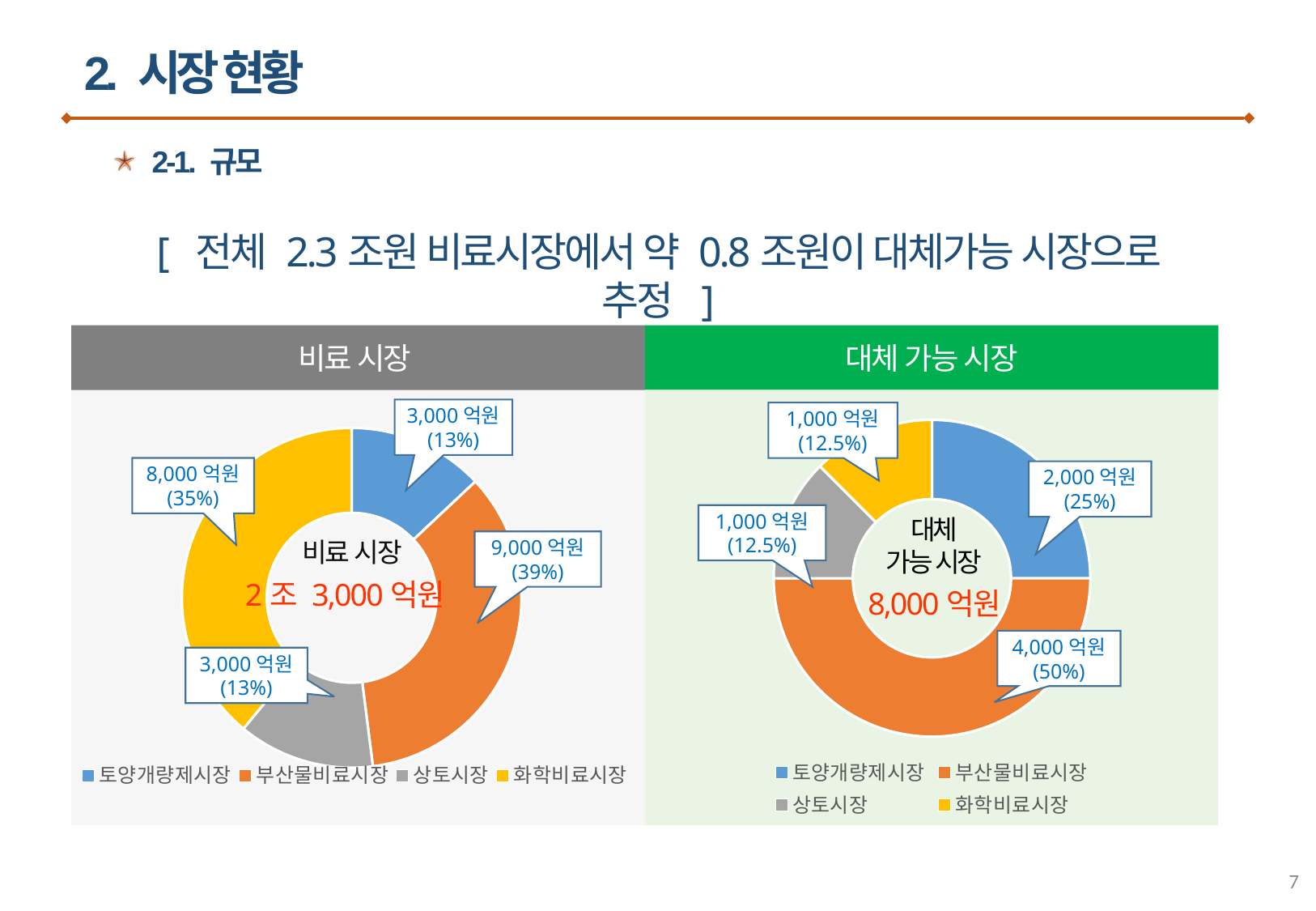
In the right chart (대체 가능 시장), what is the value for 토양개량제시장? 2,000 억원 In the right chart (대체 가능 시장), which is larger, 토양개량제시장 or 상토시장? 토양개량제시장 What kind of chart is the right chart (대체 가능 시장)? Donut (pie) chart How many categories does the legend of the left chart (비료 시장) list? 4 In the left chart (비료 시장), what share of the pie does 화학비료시장 hold? 35% In the right chart (대체 가능 시장), which category has the largest value? 부산물비료시장 In the right chart (대체 가능 시장), what total is shown in the centre of the donut? 8,000 억원 In the left chart (비료 시장), what total is shown in the centre of the donut? 2 조 3,000 억원 In the left chart (비료 시장), what is the difference between 부산물비료시장 and 화학비료시장? 1,000 억원 In the left chart (비료 시장), what is the value for 부산물비료시장? 9,000 억원 In the left chart (비료 시장), which category has the largest value? 부산물비료시장 In the right chart (대체 가능 시장), what share of the pie does 부산물비료시장 hold? 50%